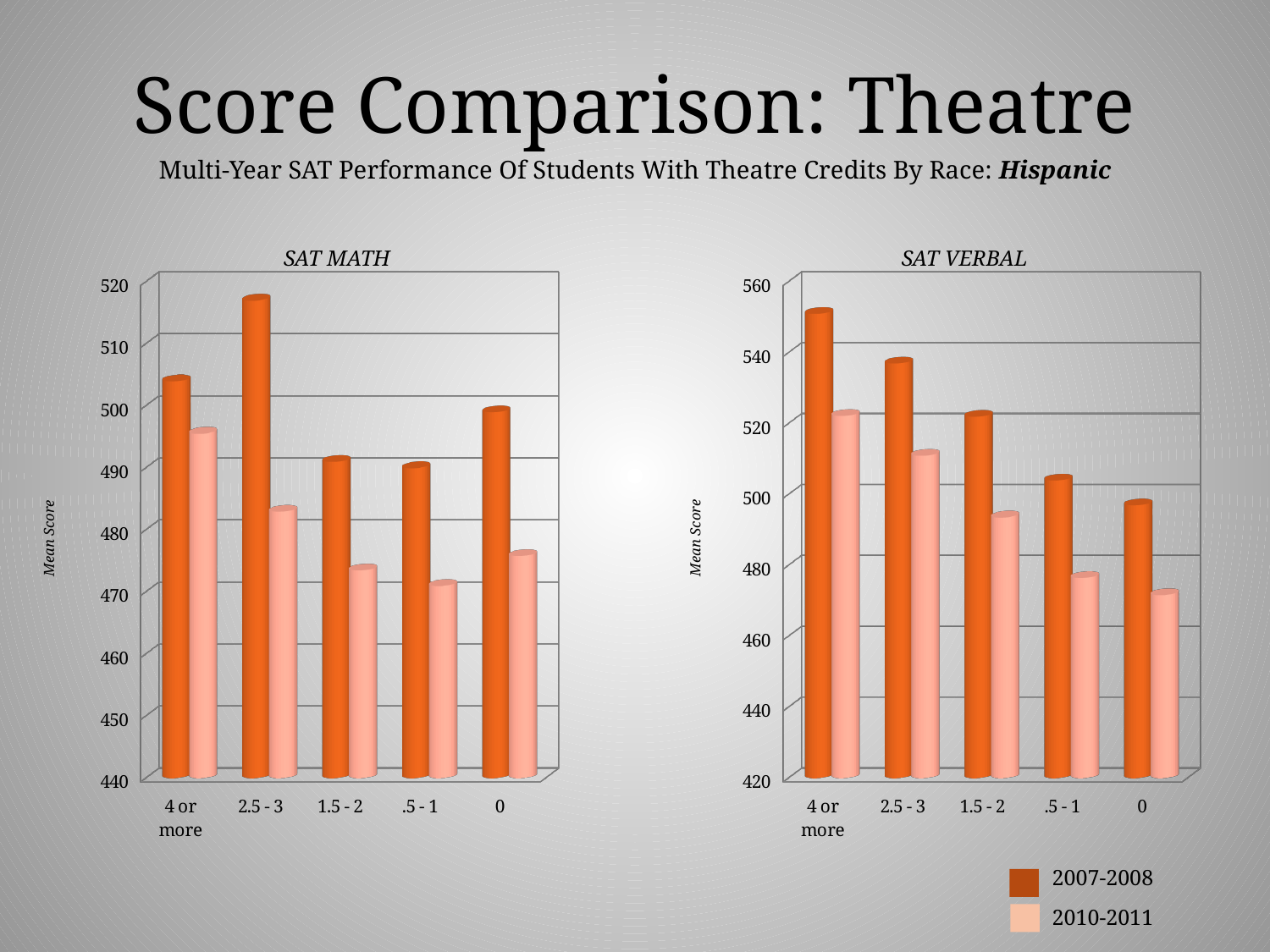
In the SAT VERBAL chart, do the 2007-2008 bars rise or fall from left to right along the x axis? fall What kind of chart is the SAT MATH chart? bar chart In the SAT VERBAL chart, is the 2007-2008 value for 4 or more greater or less than 540? greater In the SAT MATH chart, which category has the highest 2007-2008 bar? 2.5 - 3 In the SAT VERBAL chart, which category has the highest 2007-2008 bar? 4 or more In the SAT MATH chart, is the 2010-2011 value for .5 - 1 greater or less than 480? less What is the label on the vertical axis of the SAT VERBAL chart? Mean Score In the SAT MATH chart, for the 4 or more category, which series has the larger value, 2007-2008 or 2010-2011? 2007-2008 In the SAT MATH chart, is the 2007-2008 value for 2.5 - 3 greater or less than 510? greater How many series does the legend list? 2 In the SAT VERBAL chart, which category has the lowest 2010-2011 bar? 0 How many credit categories are shown on the x axis of the SAT VERBAL chart? 5